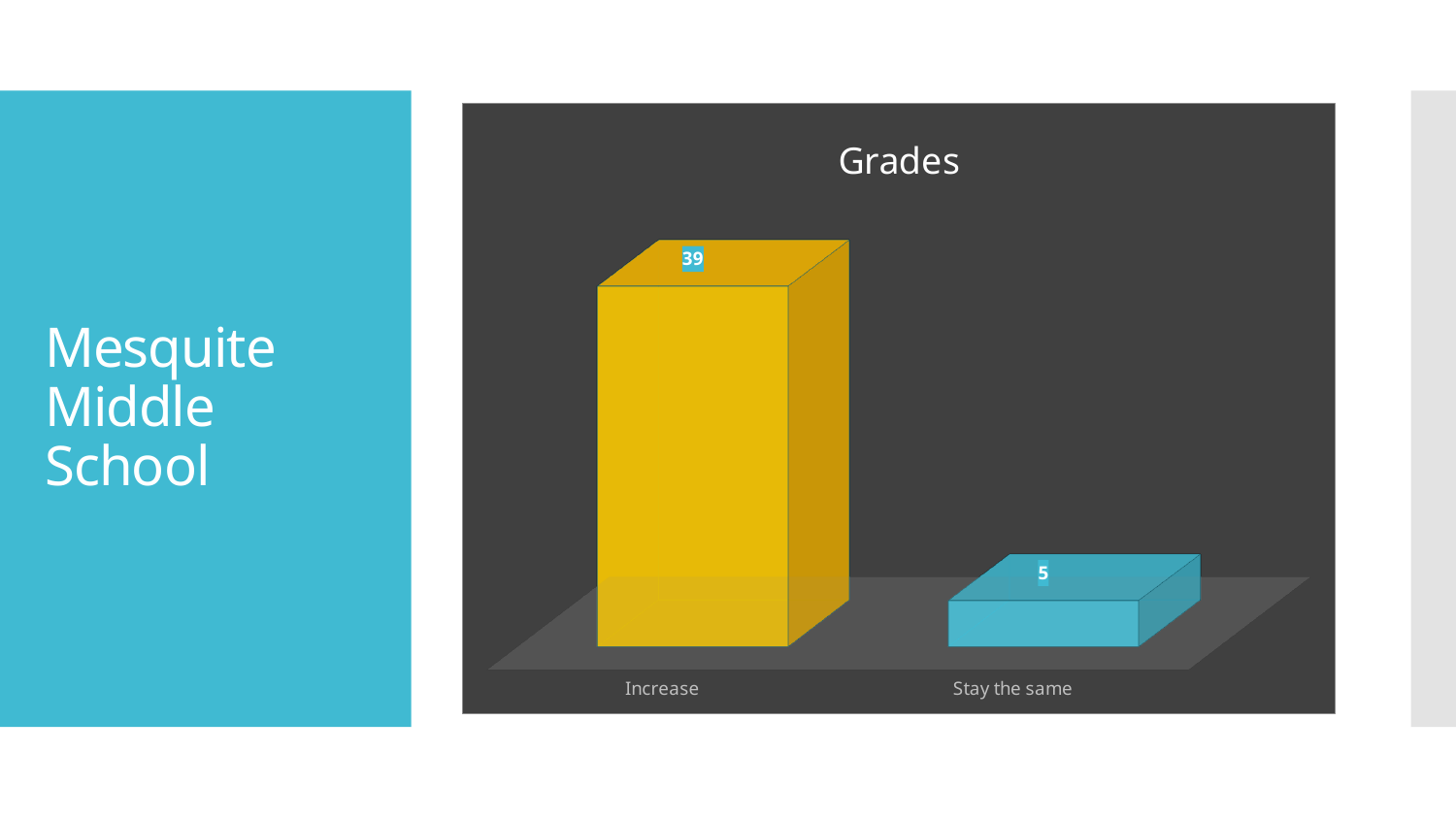
What is the title of the chart? Grades Which category has the highest value in the Grades chart? Increase What is the value for Increase in the Grades chart? 39 What colour is the bar for Stay the same? Blue How many categories are shown in the Grades chart? 2 What is the value for Stay the same in the Grades chart? 5 Which category has the lowest value in the Grades chart? Stay the same What is the difference between the values for Increase and Stay the same? 34 What kind of chart is shown on the slide? Bar chart Which is larger, the value for Increase or the value for Stay the same? Increase